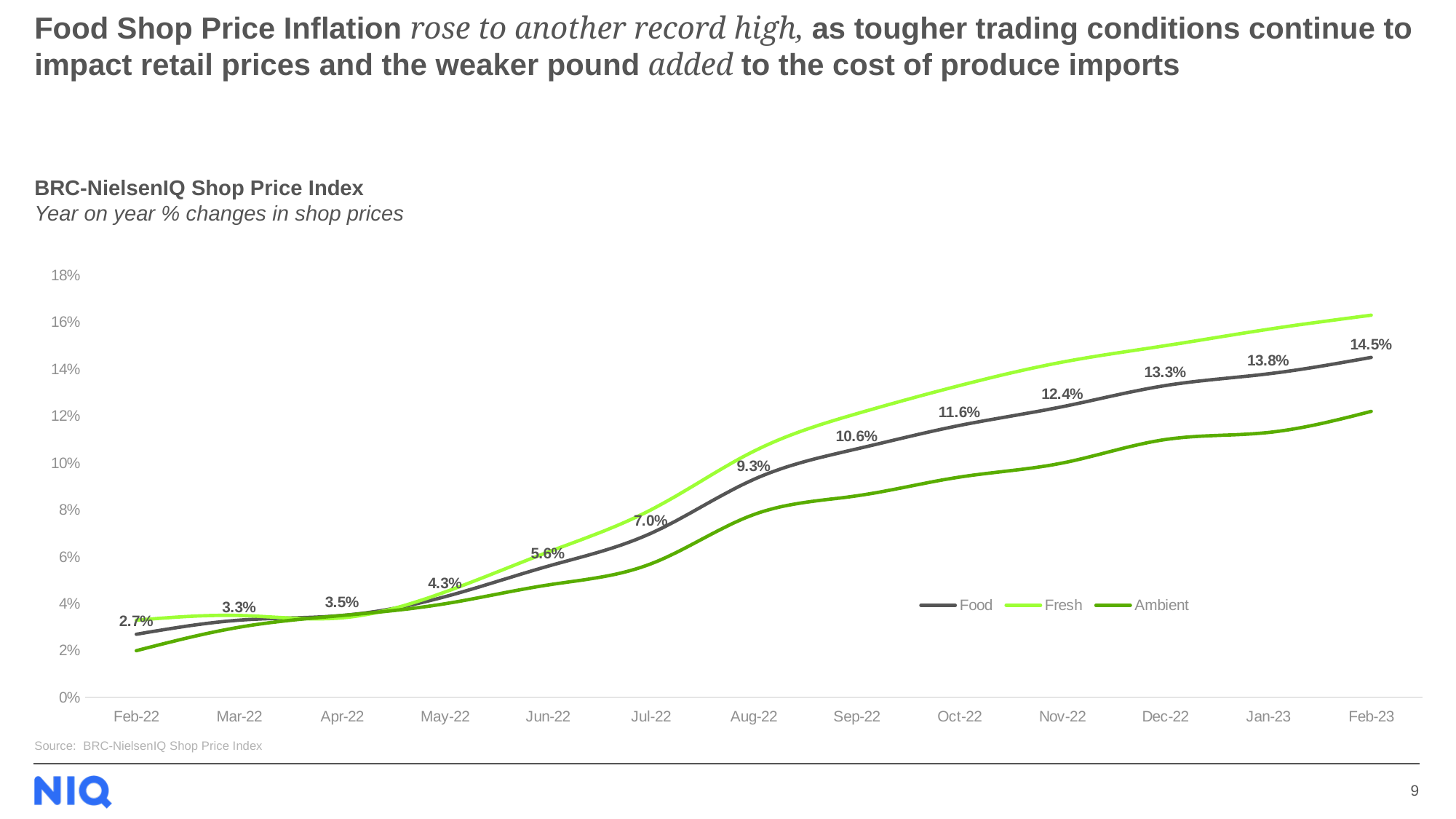
How many months are shown on the x axis? 13 What kind of chart is this? Line chart In which month is the Food series lowest? Feb-22 How many series does the legend list? 3 Is the Ambient value for Feb-23 greater or less than 14%? less What is the difference between the Food values for Feb-23 and Jan-23? 0.7% What is the Food value for Feb-22? 2.7% Which is larger, the Food value for Jul-22 or for Jun-22? Jul-22 What is the Food value for Feb-23? 14.5% Is the Fresh value for Feb-23 greater or less than 16%? greater In which month is the Food series highest? Feb-23 What is the Food value for Aug-22? 9.3%